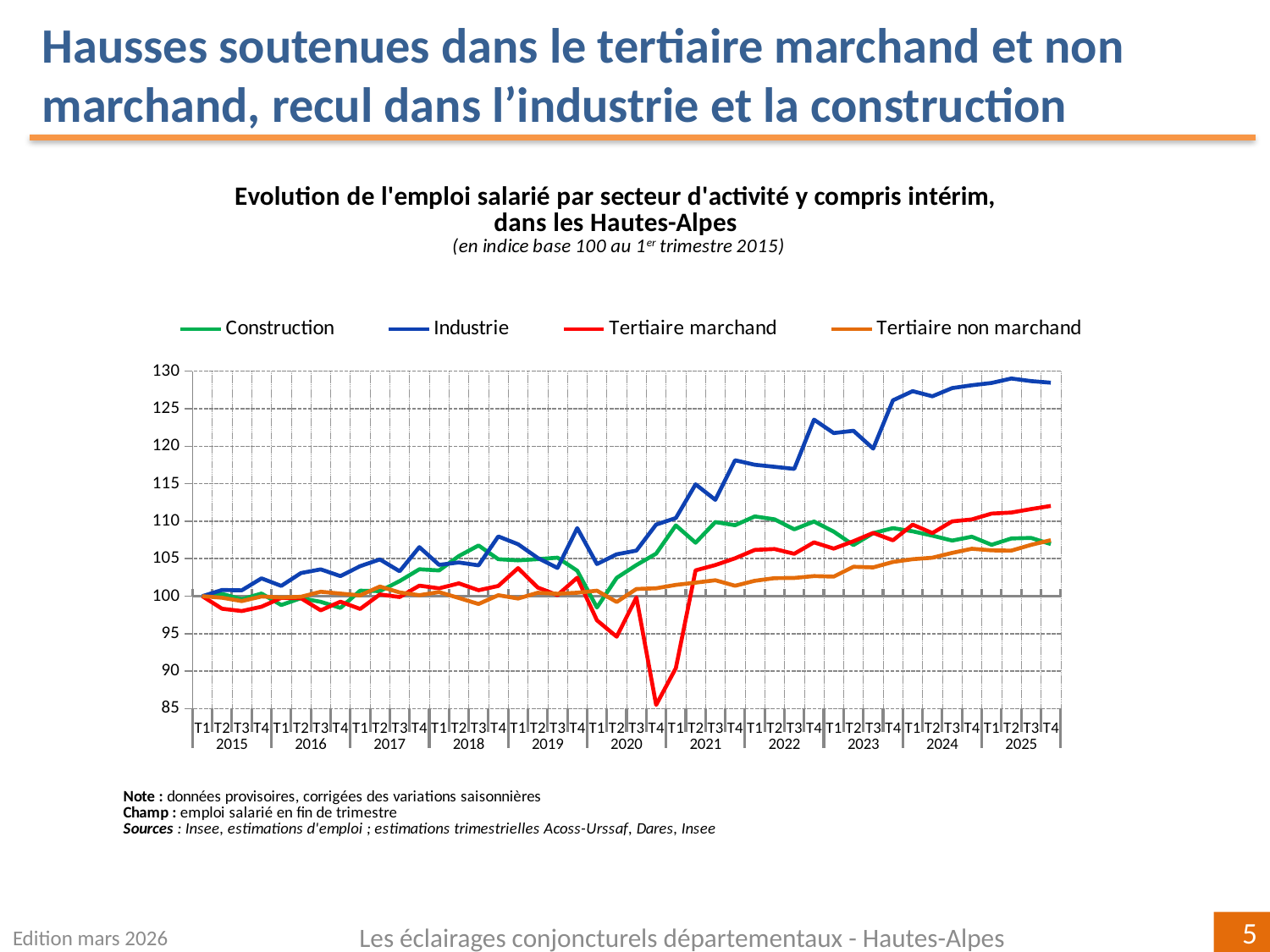
Which series has the highest value at T4 2025? Industrie Is the value for Construction at T4 2025 greater or less than 110? less Which colour is used for the Tertiaire non marchand series? orange What kind of chart is shown on the slide? line chart How many series does the legend list? 4 Is the value for Industrie at T4 2025 greater or less than 125? greater How many years are shown along the x axis of the chart? 11 Does the Industrie series rise or fall overall from 2015 to 2025? rise What is the index value of every series at T1 2015, the base quarter? 100 Is the value for Tertiaire marchand at T4 2020 greater or less than 90? less Which series reaches the lowest point anywhere on the chart? Tertiaire marchand At T4 2025, which is larger: Tertiaire marchand or Tertiaire non marchand? Tertiaire marchand